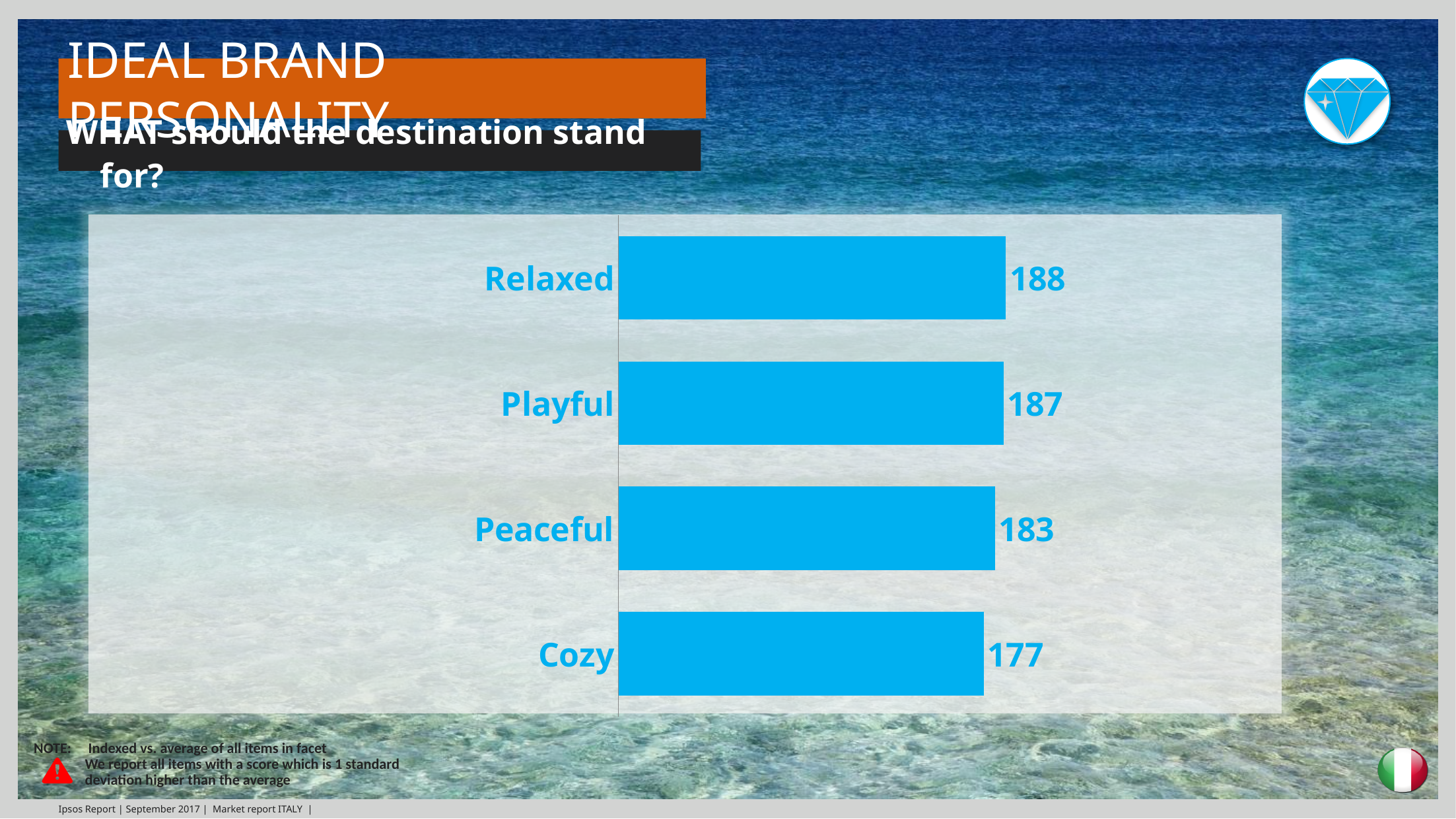
What is the difference between the values for Playful and Peaceful? 4 What is the difference between the values for Relaxed and Cozy? 11 What is the value for Relaxed? 188 What is the value for Peaceful? 183 What kind of chart is shown on the slide? Bar chart Which category has the lowest value? Cozy What colour are the bars in the chart? Blue How many categories are shown in the chart? 4 What is the value for Playful? 187 Which has a larger value, Peaceful or Cozy? Peaceful What is the value for Cozy? 177 Which category has the highest value? Relaxed